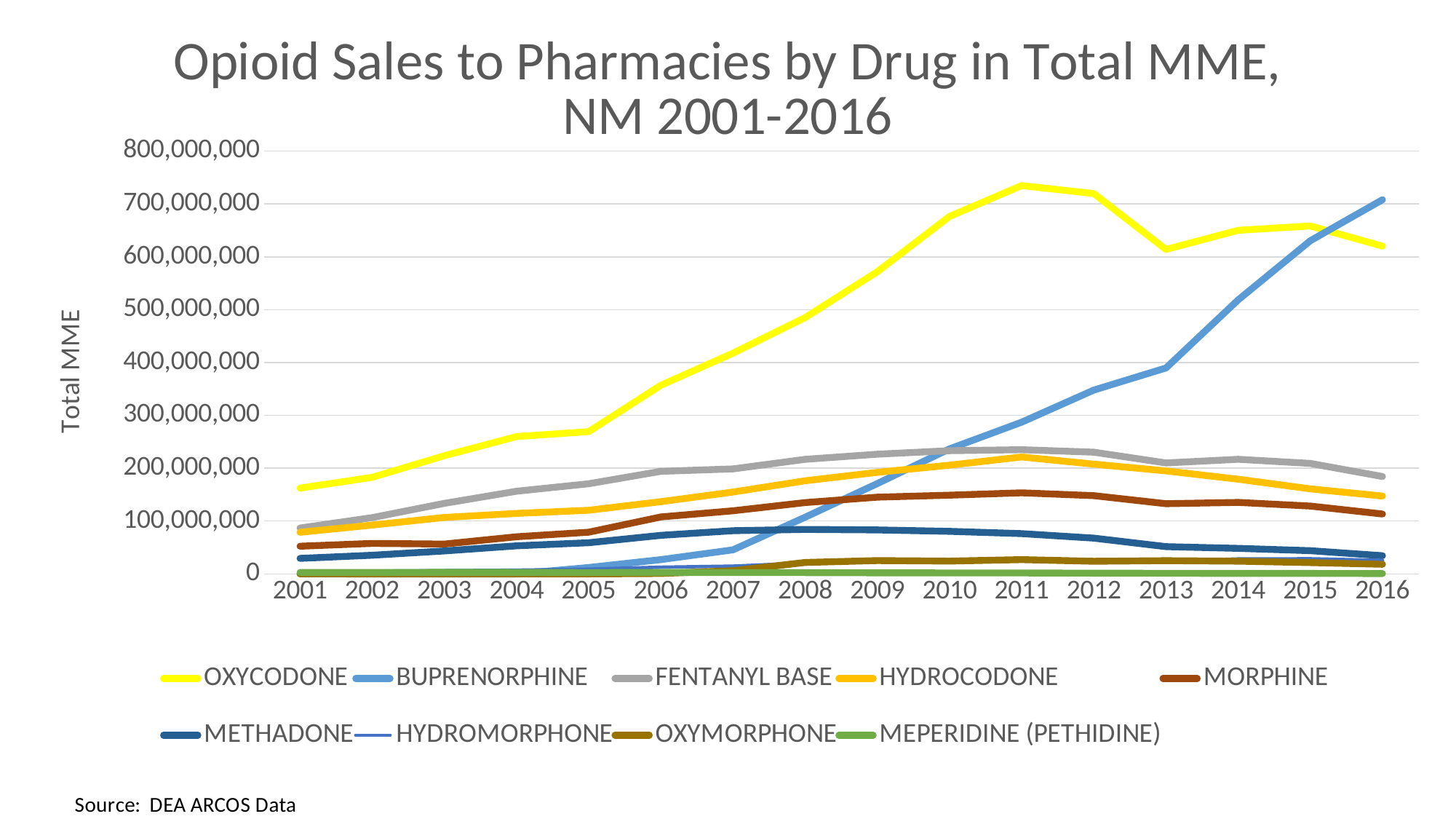
How many years are plotted along the x axis? 16 Which drug has the highest total MME in 2011? OXYCODONE Which drug has the lowest total MME across the whole period? MEPERIDINE (PETHIDINE) Does the BUPRENORPHINE line rise or fall from 2001 to 2016? rise In 2016, which is larger: FENTANYL BASE or HYDROCODONE? FENTANYL BASE Which drug has the highest total MME in 2016? BUPRENORPHINE Is the value for BUPRENORPHINE in 2012 greater or less than 400,000,000? less Is the value for OXYCODONE in 2011 greater or less than 700,000,000? greater What kind of chart is shown on the slide? line chart How many series does the legend list? 9 Is the value for OXYCODONE in 2001 greater or less than 200,000,000? less In which year does the OXYCODONE line reach its peak? 2011